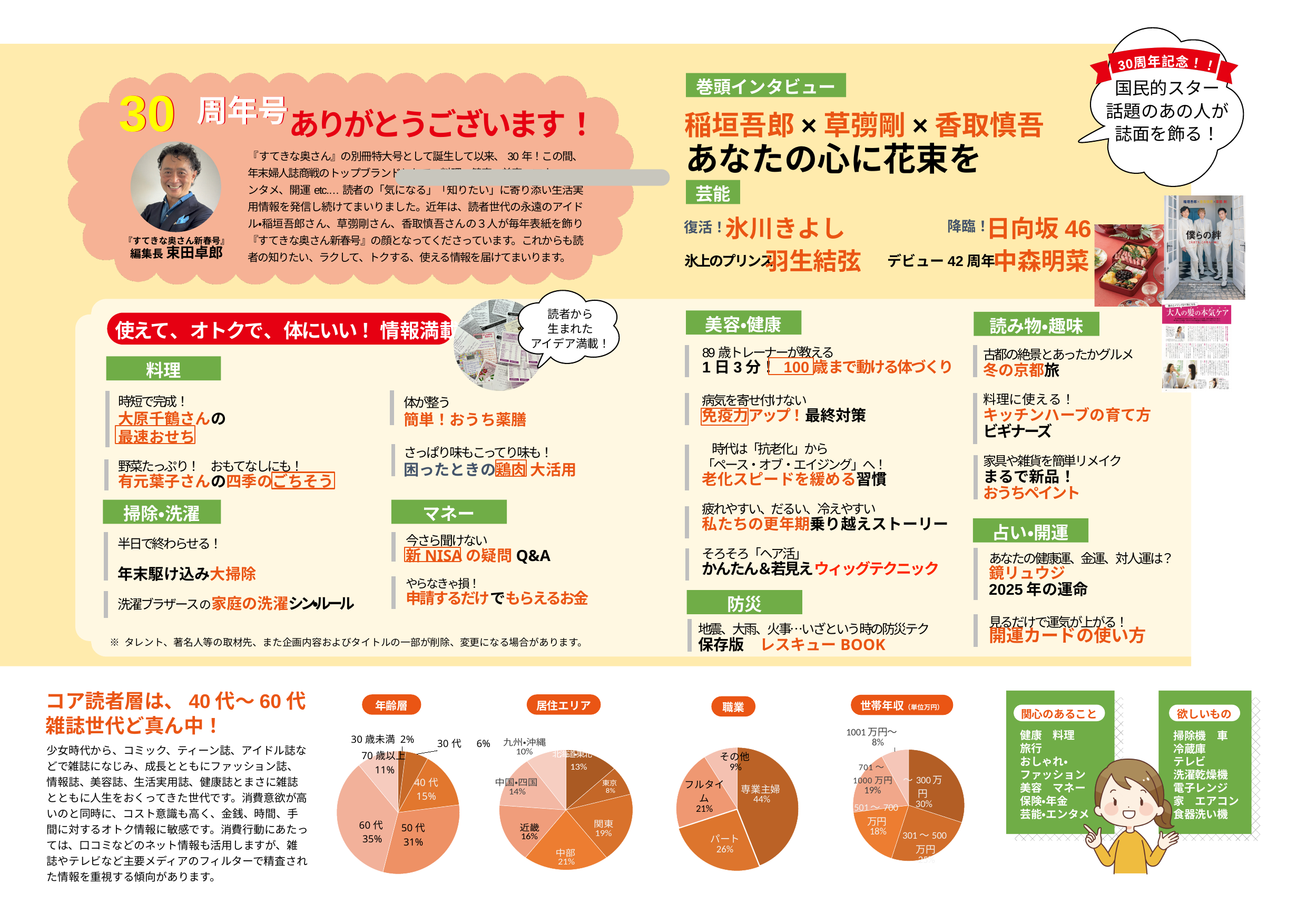
In the 職業 pie chart, what is the difference between パート and フルタイム? 5% In the 年齢層 pie chart, what percentage is shown for 50代? 31% In the 世帯年収 pie chart, what percentage is shown for 701〜1000万円? 19% In the 年齢層 pie chart, which age group has the largest share? 60代 In the 職業 pie chart, what percentage is shown for 専業主婦? 44% In the 年齢層 pie chart, what percentage is shown for 60代? 35% What type of chart is used for the 職業 data? Pie chart How many categories does the 居住エリア pie chart show? 7 In the 年齢層 pie chart, which age group has the smallest share? 30歳未満 In the 居住エリア pie chart, which is larger, 関東 or 近畿? 関東 In the 居住エリア pie chart, what percentage is shown for 中部? 21% In the 年齢層 pie chart, what is the difference between the shares of 60代 and 40代? 20%